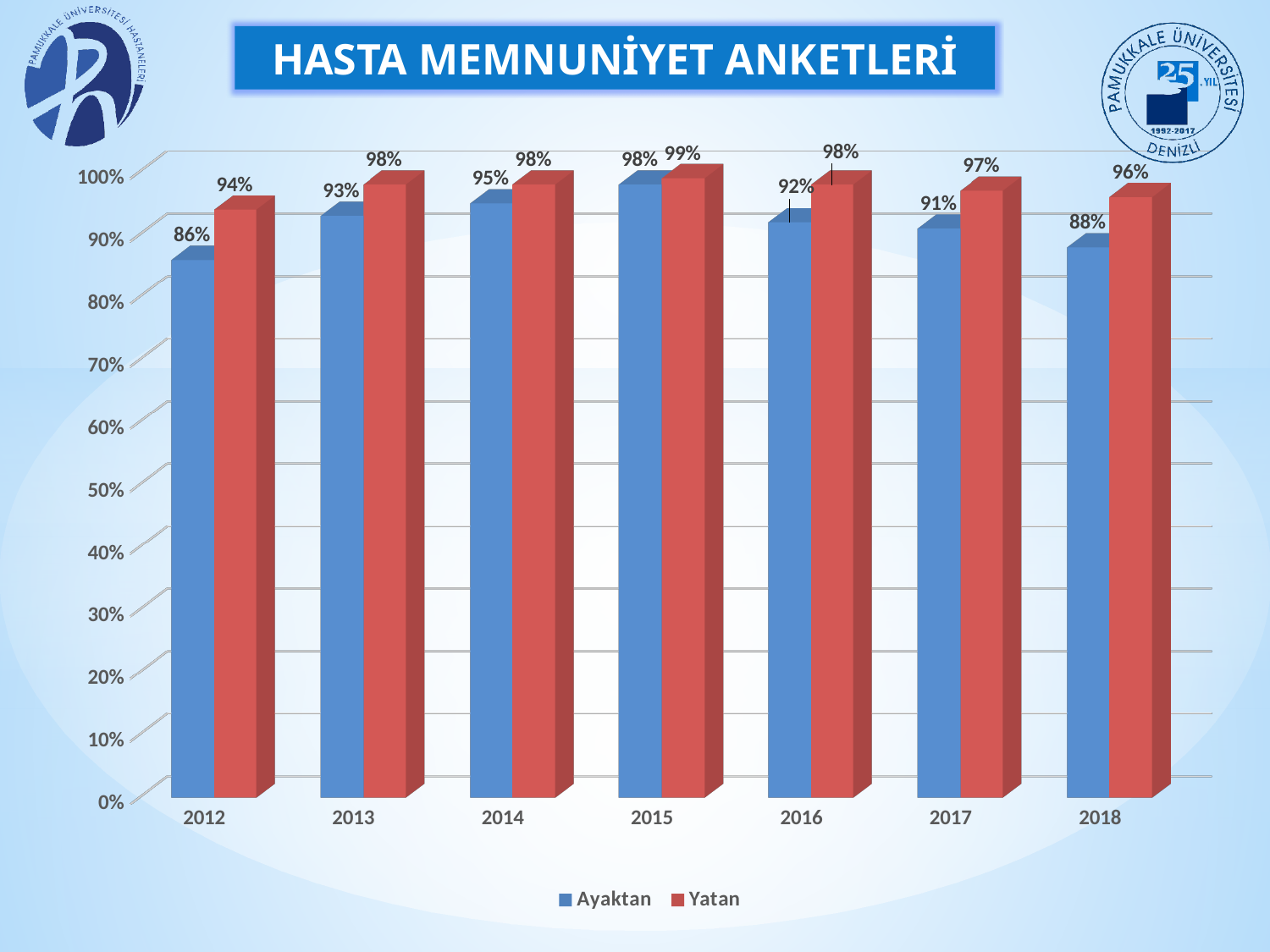
What kind of chart is shown on the slide? Bar chart Which is larger in 2016, the Ayaktan value or the Yatan value? Yatan What is the difference between the Yatan and Ayaktan values in 2012? 8% What is the Yatan value for 2017? 97% What is the Ayaktan value for 2012? 86% How many series does the legend list? 2 Which year has the highest Ayaktan value? 2015 What is the title of the slide? HASTA MEMNUNİYET ANKETLERİ What is the Ayaktan value for 2018? 88% How many years are shown on the x axis? 7 Which year has the lowest Ayaktan value? 2012 What is the Yatan value for 2015? 99%